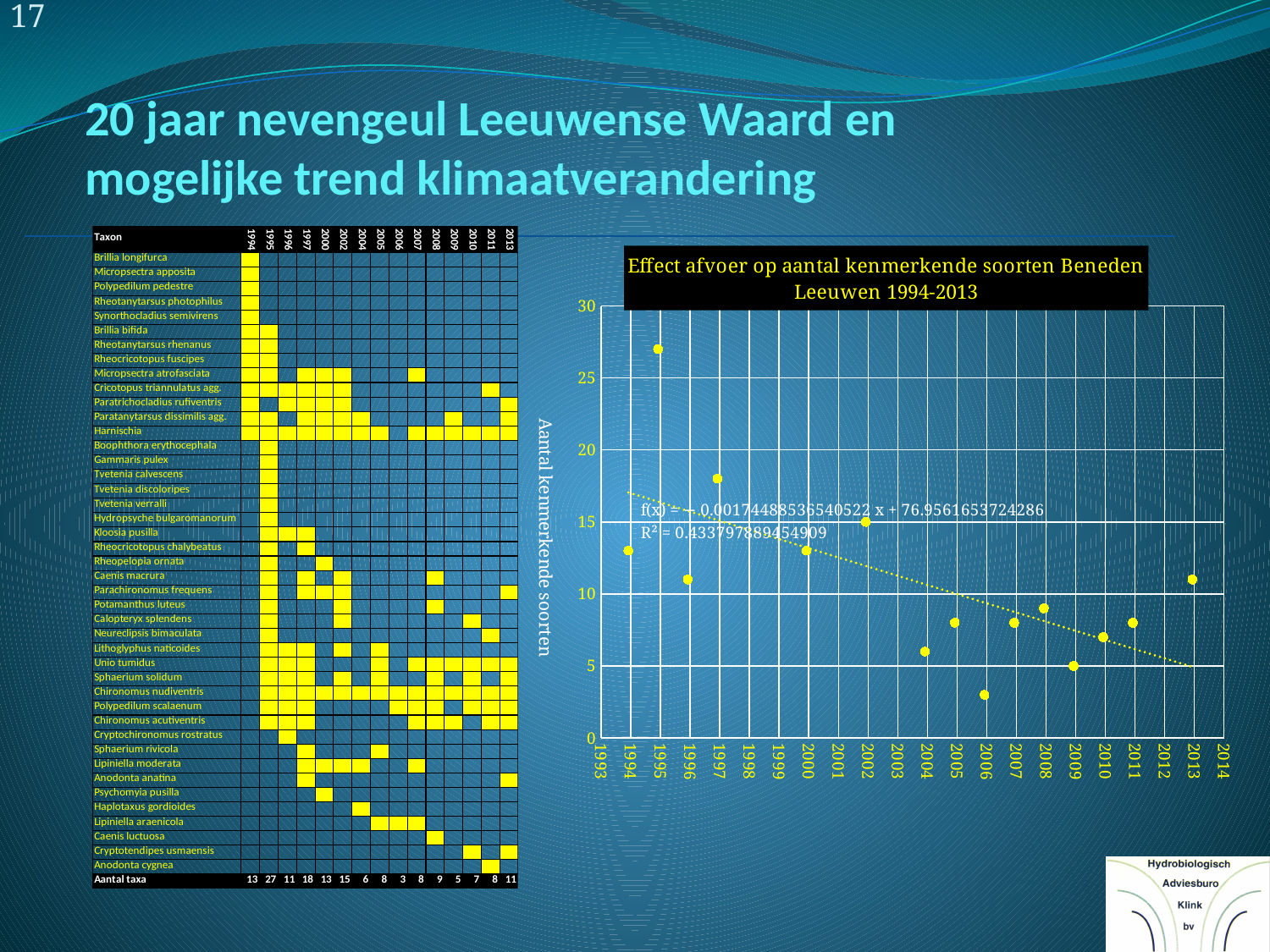
In the chart on the right, is the value for 2013 greater or less than 10? greater In the chart on the right, is the value for 2006 greater or less than 5? less In the chart on the right, which year has a higher value, 1994 or 2004? 1994 What is the label of the vertical axis of the chart on the right? Aantal kenmerkende soorten In the chart on the right, is the value for 1995 greater or less than 25? greater How many data points are plotted in the chart on the right? 15 In the chart on the right, which year has the highest number of characteristic species? 1995 What is the title of the chart on the right side of the slide? Effect afvoer op aantal kenmerkende soorten Beneden Leeuwen 1994-2013 What kind of chart is shown on the right side of the slide? scatter chart In the chart on the right, do the values generally rise or fall from 1994 to 2013? fall In the chart on the right, which year has the lowest number of characteristic species? 2006